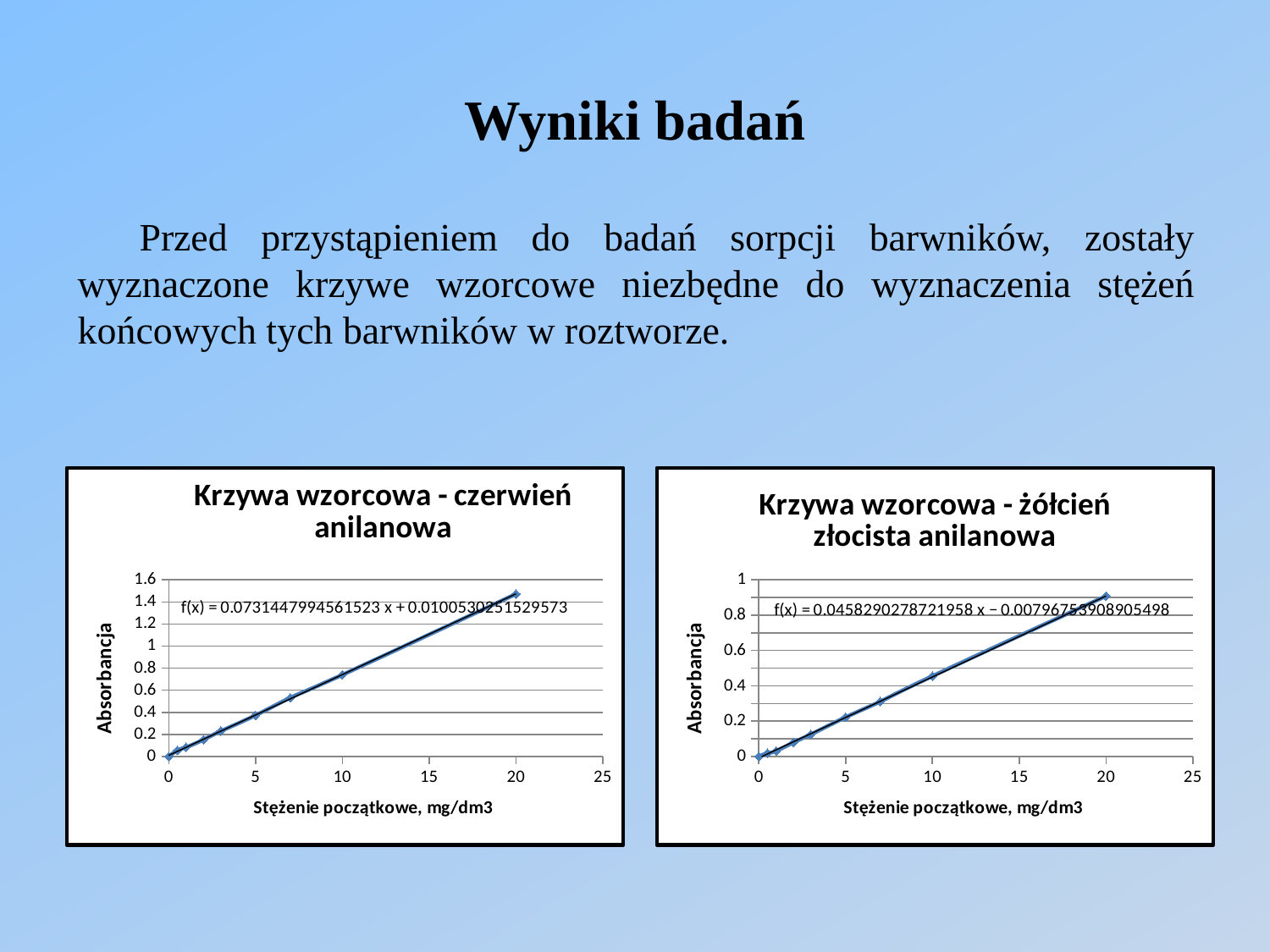
What is the title of the chart on the right? Krzywa wzorcowa - żółcień złocista anilanowa In the chart 'Krzywa wzorcowa - żółcień złocista anilanowa', is the absorbance at a concentration of 20 mg/dm3 greater or less than 0.8? greater In the chart 'Krzywa wzorcowa - czerwień anilanowa', is the absorbance at a concentration of 10 mg/dm3 greater or less than 0.6? greater In the chart 'Krzywa wzorcowa - żółcień złocista anilanowa', is the absorbance at a concentration of 5 mg/dm3 greater or less than 0.4? less In the chart 'Krzywa wzorcowa - czerwień anilanowa', what kind of chart is shown? scatter chart with a trendline In the chart 'Krzywa wzorcowa - czerwień anilanowa', which concentration has the highest absorbance, 10 or 20 mg/dm3? 20 In the chart 'Krzywa wzorcowa - czerwień anilanowa', does absorbance rise or fall as the initial concentration increases? rise In the chart 'Krzywa wzorcowa - żółcień złocista anilanowa', does absorbance rise or fall as the initial concentration increases? rise What is the title of the chart on the left? Krzywa wzorcowa - czerwień anilanowa